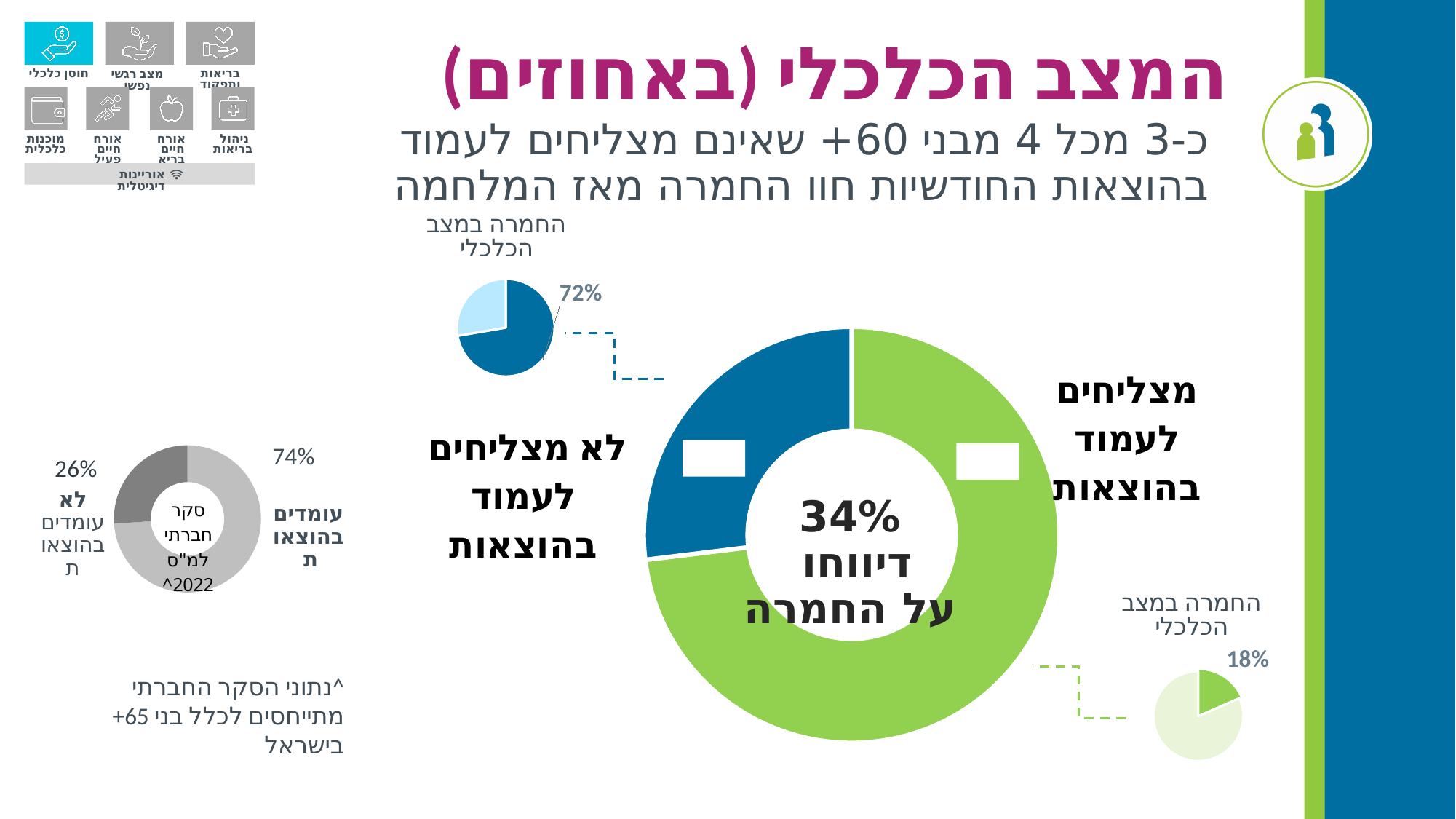
In the large central donut chart, which segment is larger: מצליחים לעמוד בהוצאות or לא מצליחים לעמוד בהוצאות? מצליחים לעמוד בהוצאות What percentage is printed in the centre of the large central donut chart? 34% In the small green pie chart at the bottom right (החמרה במצב הכלכלי), what percentage is labelled? 18% What is the difference between the labelled shares of the blue pie chart (72%) and the green pie chart (18%)? 54% In the small donut chart on the left, which category is larger: עומדים בהוצאות or לא עומדים בהוצאות? עומדים בהוצאות In the small donut chart on the left (סקר חברתי למ"ס 2022), what is the value for לא עומדים בהוצאות? 26% How many categories does the small donut chart on the left show? 2 Which small pie chart shows a larger labelled share: the blue one at the top left (72%) or the green one at the bottom right (18%)? the blue one at the top left What kind of chart is the large central chart on the slide? donut (pie) chart In the small donut chart on the left (סקר חברתי למ"ס 2022), what is the value for עומדים בהוצאות? 74% In the small blue pie chart at the top left of the large donut (החמרה במצב הכלכלי), what percentage is labelled? 72% In the small donut chart on the left, what is the difference between the values for עומדים בהוצאות and לא עומדים בהוצאות? 48%